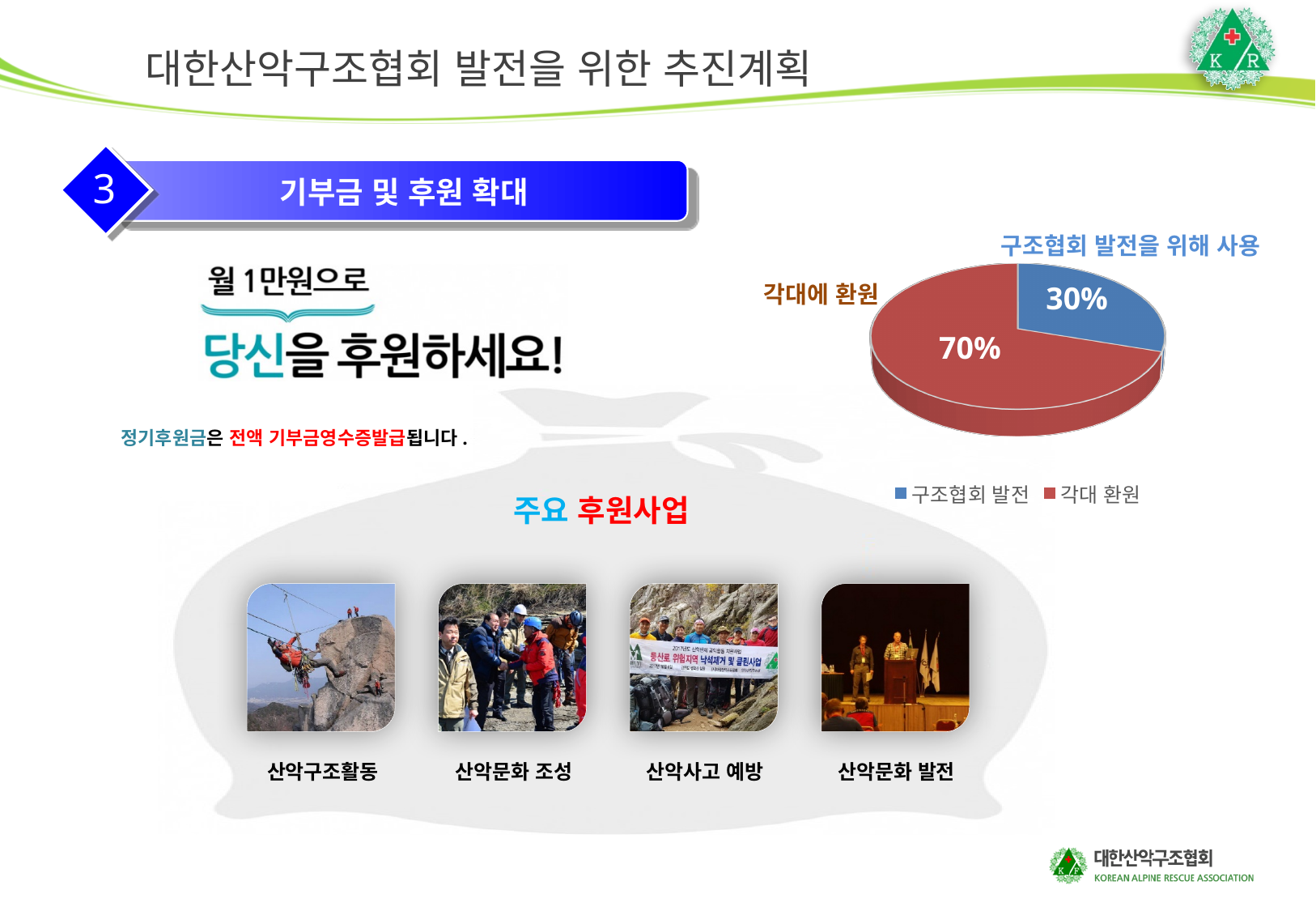
What kind of chart is shown on the slide? Pie chart What is the total of the two slices shown in the pie chart? 100% What share of the pie is labelled 각대 환원? 70% How many entries does the legend of the pie chart list? 2 What is the difference in percentage points between the 각대 환원 slice and the 구조협회 발전 slice? 40% How many slices does the pie chart have? 2 Which is larger, the 구조협회 발전 slice or the 각대 환원 slice? 각대 환원 Which slice of the pie chart is the smallest? 구조협회 발전 What share of the pie is labelled 구조협회 발전? 30% Which slice of the pie chart is the largest? 각대 환원 What colour is the 구조협회 발전 slice in the pie chart? Blue What colour is the 각대 환원 slice in the pie chart? Red